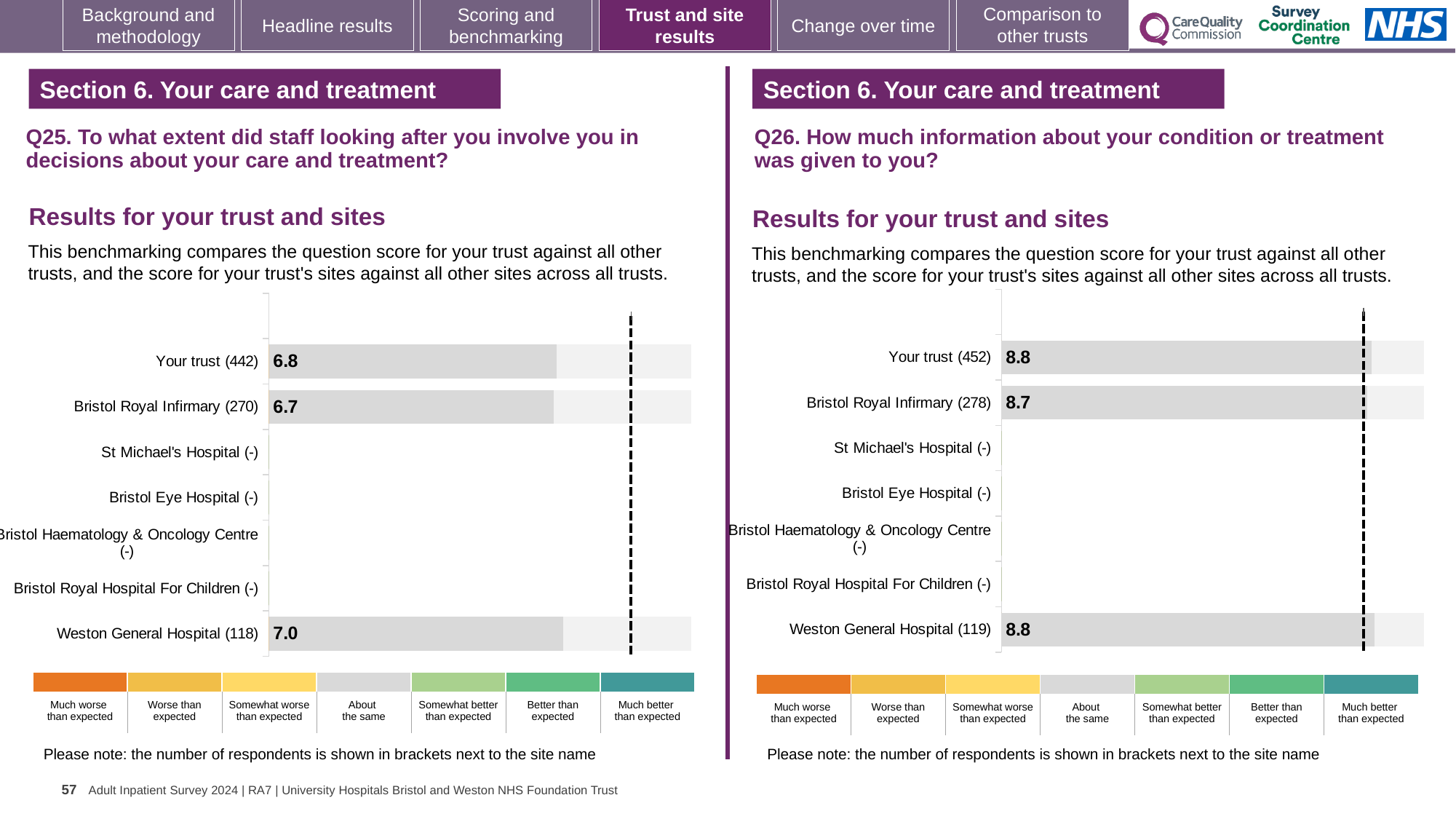
What kind of chart is used in the Q26 chart on the right? Bar chart In the Q26 chart on the right, what is the score for Weston General Hospital? 8.8 In the Q26 chart on the right, what is the score for Bristol Royal Infirmary? 8.7 In the Q25 chart on the left, how many respondents are shown in brackets for Your trust? 442 In the Q26 chart on the right, what is the difference between the Your trust score and the Bristol Royal Infirmary score? 0.1 In the Q25 chart on the left, what is the score for Your trust? 6.8 In the Q25 chart on the left, which site or trust row has the lowest score shown? Bristol Royal Infirmary In the Q25 chart on the left, which site or trust row has the highest score? Weston General Hospital How many site or trust rows are listed on the y axis of the Q25 chart on the left? 7 In the Q25 chart on the left, what is the score for Weston General Hospital? 7.0 In the Q26 chart on the right, which is larger: the score for Your trust or the score for Bristol Royal Infirmary? Your trust In the Q25 chart on the left, what is the difference between the Weston General Hospital score and the Bristol Royal Infirmary score? 0.3